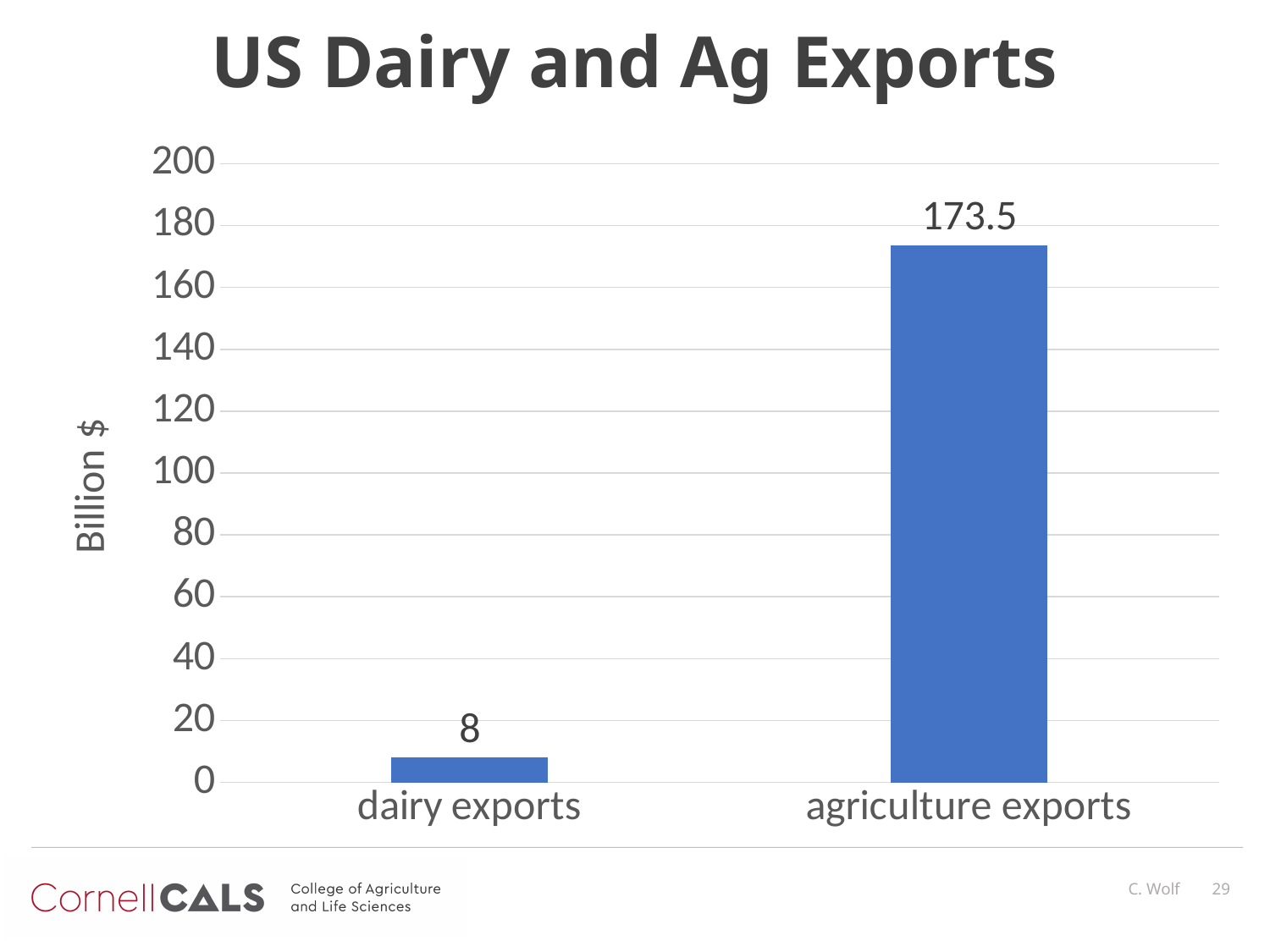
What is the value for dairy exports? 8 What is the title of the chart? US Dairy and Ag Exports Is the value for dairy exports greater or less than 20? less How many categories are shown in the chart? 2 Is the value for agriculture exports greater or less than 160? greater What kind of chart is shown on the slide? bar chart Which is larger, dairy exports or agriculture exports? agriculture exports What is the label of the vertical axis? Billion $ Which category has the highest value? agriculture exports Which category has the lowest value? dairy exports What is the value for agriculture exports? 173.5 What is the difference between agriculture exports and dairy exports? 165.5